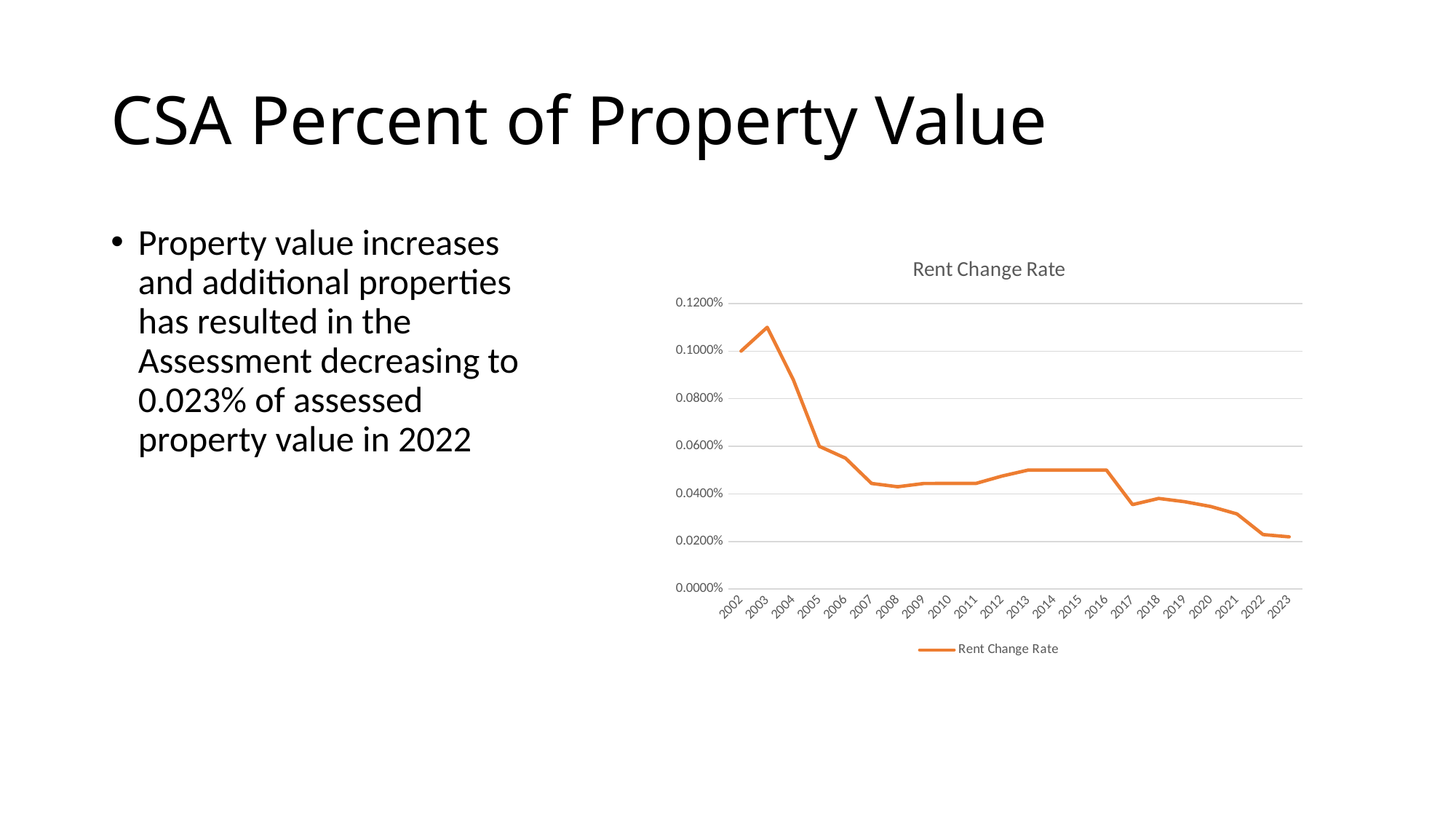
Is the Rent Change Rate for 2007 greater or less than 0.0600%? less What kind of chart is shown on the slide? Line chart Is the Rent Change Rate for 2013 greater or less than 0.0400%? greater Is the Rent Change Rate for 2017 greater or less than 0.0400%? less Overall, does the Rent Change Rate rise or fall from 2002 to 2023? Fall Which year has the larger Rent Change Rate, 2016 or 2017? 2016 How many years are plotted along the x axis of the chart? 22 Which year has the highest Rent Change Rate? 2003 How many series does the chart legend list? 1 What is the title of the chart? Rent Change Rate Which year has the larger Rent Change Rate, 2002 or 2010? 2002